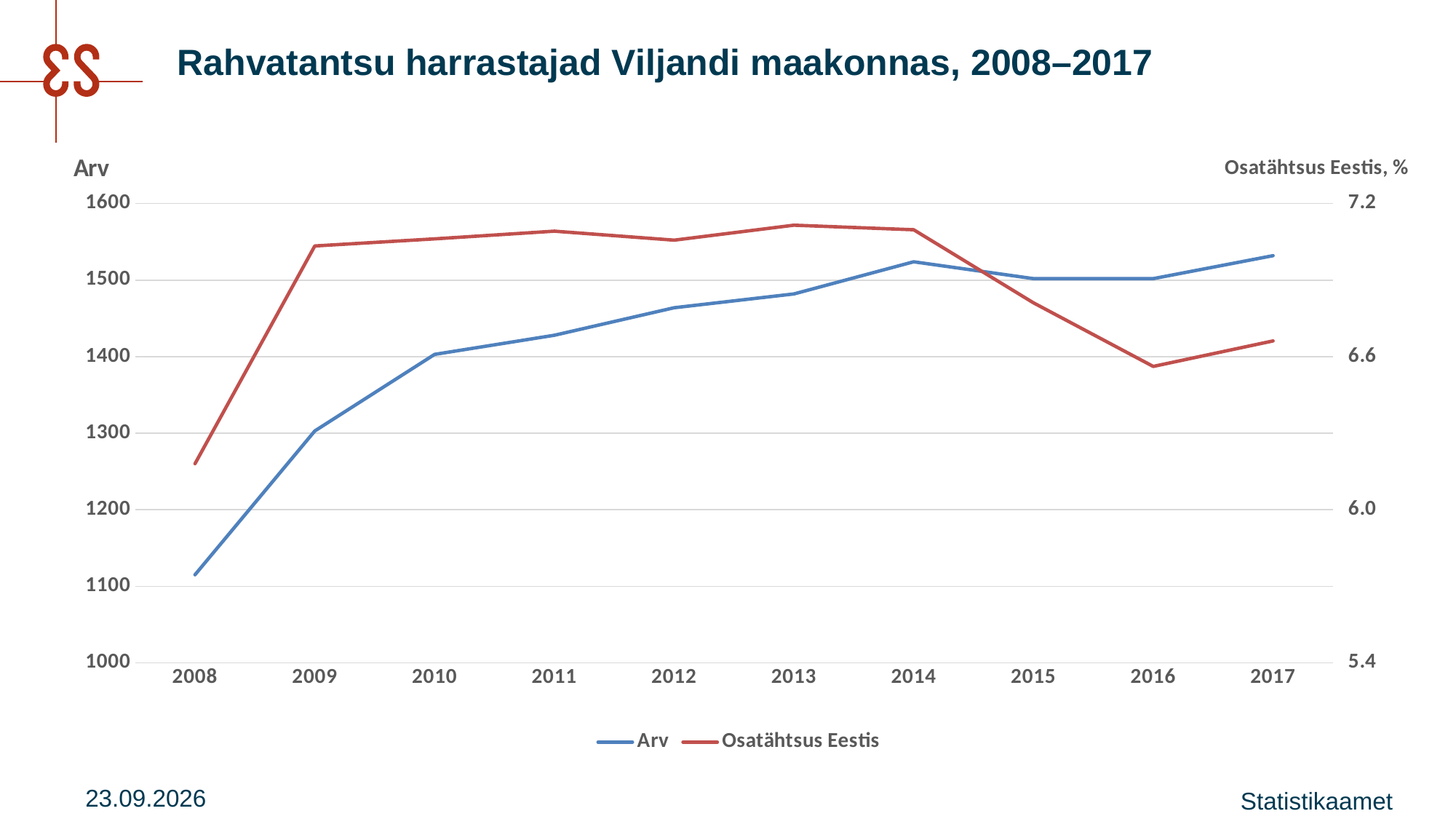
In which year is the Osatähtsus Eestis series at its lowest? 2008 How many series does the legend list? 2 Is the Arv value for 2012 greater or less than 1400? greater What is the title of the right-hand vertical axis? Osatähtsus Eestis, % In which year is the Arv series at its lowest? 2008 How many years are plotted along the x axis? 10 Is the Osatähtsus Eestis value for 2008 greater or less than 6.0? greater Which year has the larger Arv value, 2014 or 2015? 2014 What kind of chart is shown on the slide? line chart Does the Arv series rise or fall from 2008 to 2014? rise Is the Arv value for 2008 greater or less than 1200? less